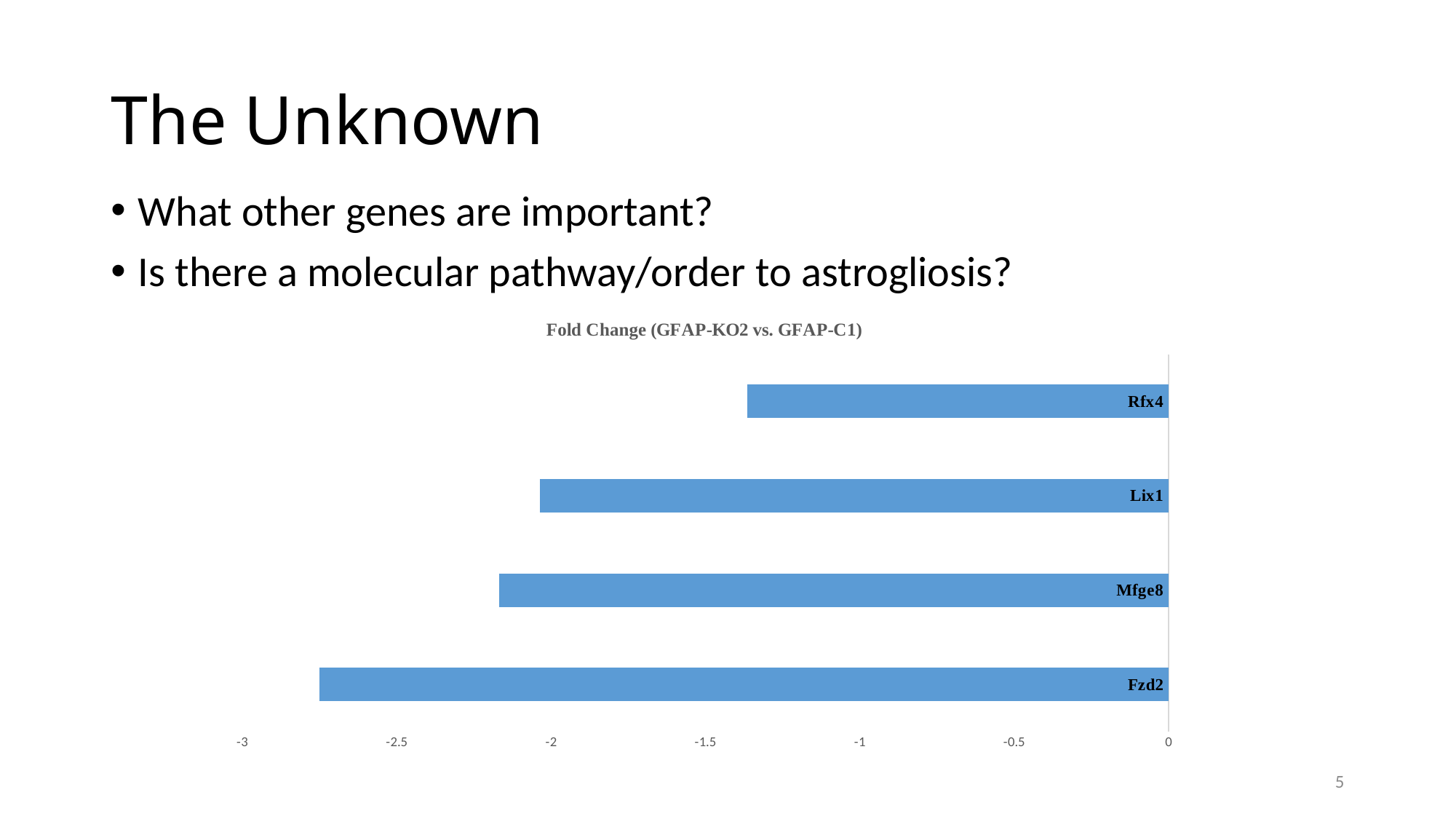
What is the title of the chart? Fold Change (GFAP-KO2 vs. GFAP-C1) Which bar is longer, Mfge8 or Lix1? Mfge8 Which gene has the highest (least negative) fold change? Rfx4 Is the fold change for Rfx4 greater or less than -1? less Which has the larger fold change value, Rfx4 or Fzd2? Rfx4 Is the fold change for Mfge8 greater or less than -2? less Is the fold change for Fzd2 greater or less than -2.5? less Do the fold change values increase or decrease going from the top bar (Rfx4) to the bottom bar (Fzd2)? decrease What kind of chart is shown on the slide? bar chart How many genes (categories) are plotted in the chart? 4 Which gene has the lowest (most negative) fold change? Fzd2